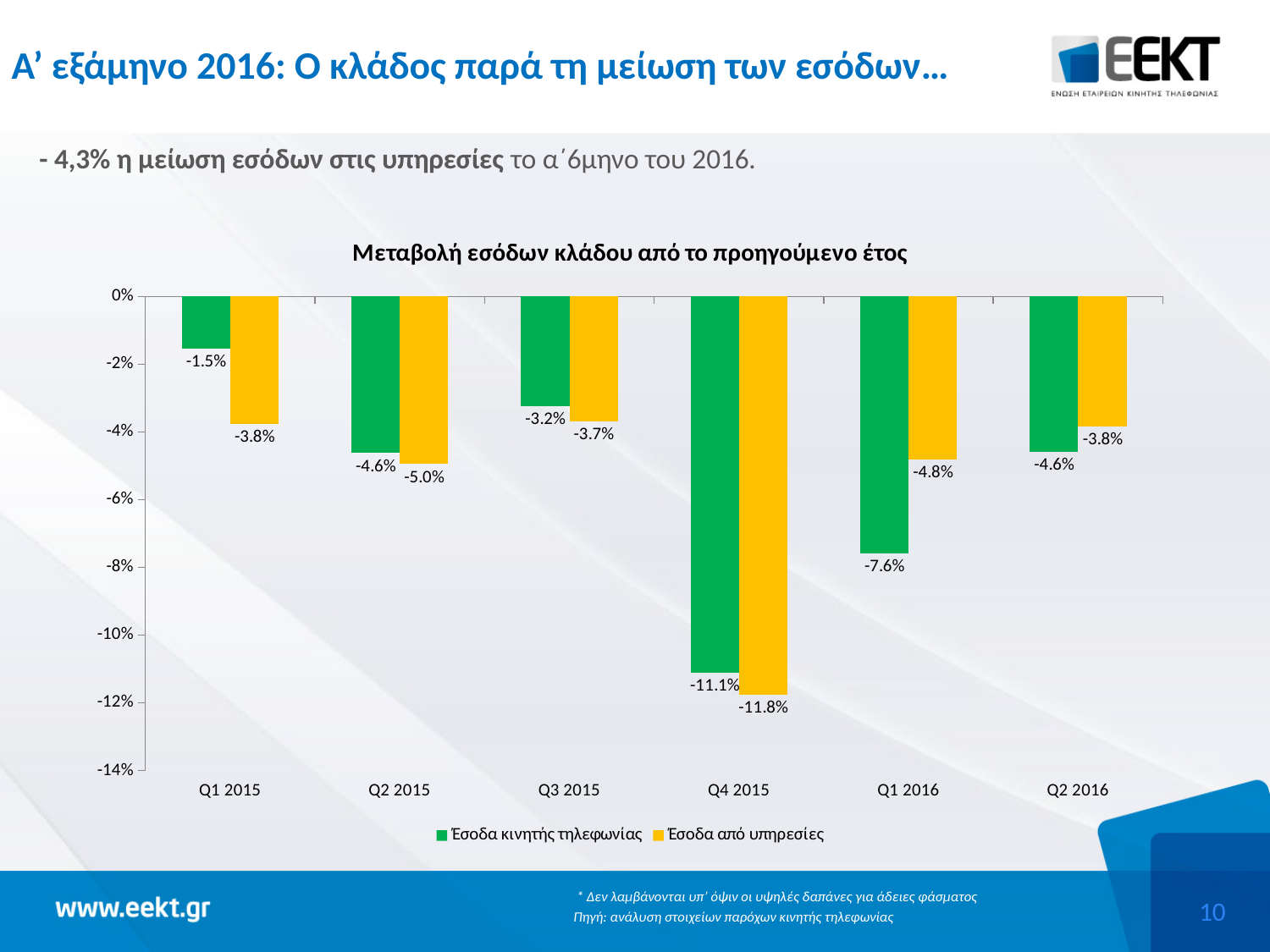
Which is larger in Q4 2015: the value for Έσοδα κινητής τηλεφωνίας or for Έσοδα από υπηρεσίες? Έσοδα κινητής τηλεφωνίας In which quarter is the value for Έσοδα από υπηρεσίες lowest? Q4 2015 How many series does the legend list? 2 What is the value for Έσοδα κινητής τηλεφωνίας in Q1 2015? -1.5% What is the value for Έσοδα από υπηρεσίες in Q1 2016? -4.8% What is the value for Έσοδα από υπηρεσίες in Q2 2016? -3.8% What is the value for Έσοδα κινητής τηλεφωνίας in Q4 2015? -11.1% What is the title of the chart? Μεταβολή εσόδων κλάδου από το προηγούμενο έτος What is the difference between the Έσοδα κινητής τηλεφωνίας and Έσοδα από υπηρεσίες values in Q1 2016? 2.8 percentage points In which quarter is the value for Έσοδα κινητής τηλεφωνίας highest? Q1 2015 How many quarters are shown on the x axis? 6 What type of chart is shown on the slide? bar chart